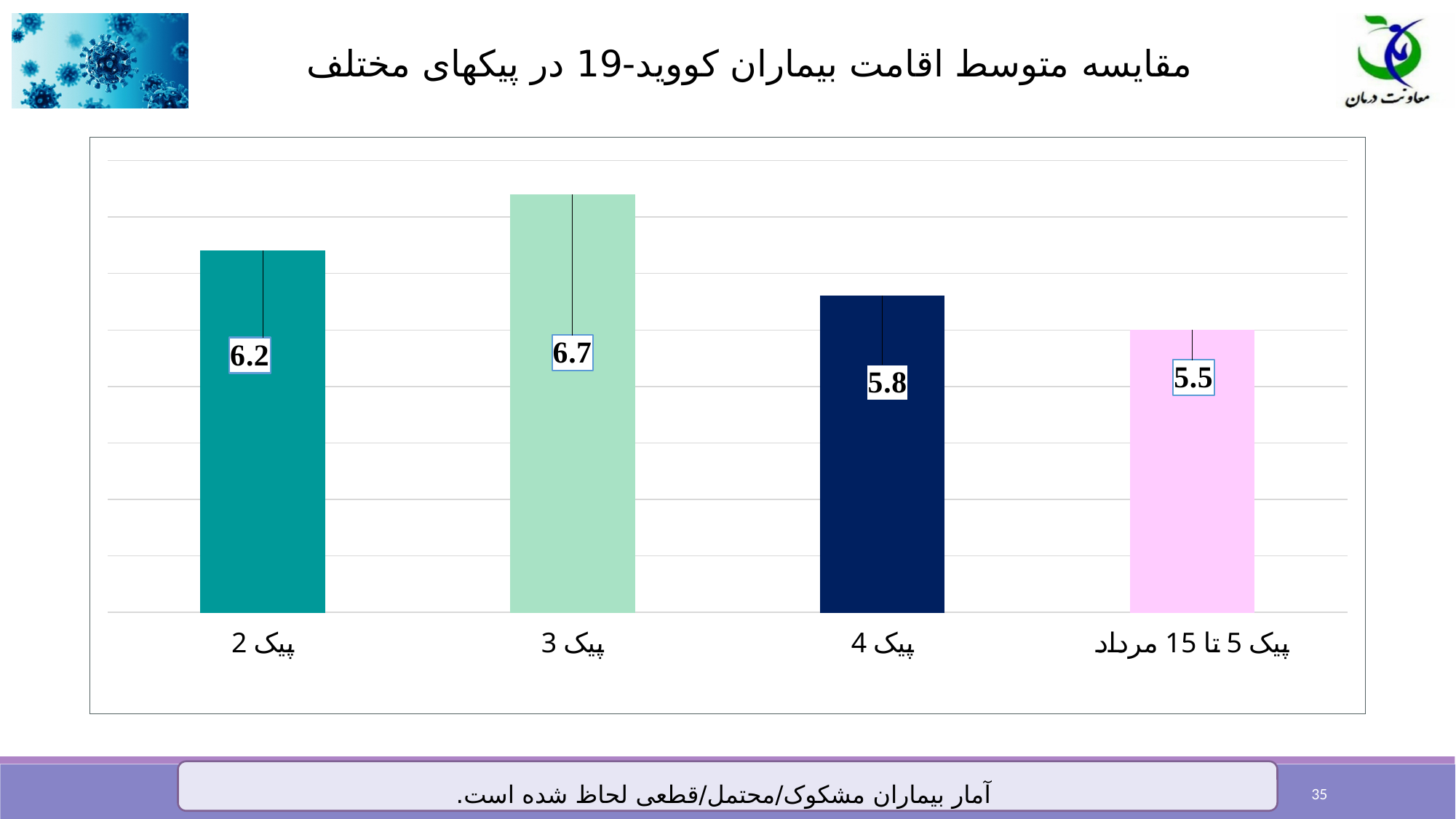
What is the value for پیک 3? 6.7 Which is larger, the value for پیک 2 or the value for پیک 4? پیک 2 What kind of chart is shown on the slide? bar chart What is the value for پیک 5 تا 15 مرداد? 5.5 What is the value for پیک 2? 6.2 What is the value for پیک 4? 5.8 What is the title of the chart on the slide? مقایسه متوسط اقامت بیماران کووید-19 در پیکهای مختلف How many categories are shown in the chart? 4 Which category has the lowest value? پیک 5 تا 15 مرداد What is the difference between the values for پیک 4 and پیک 5 تا 15 مرداد? 0.3 What is the difference between the values for پیک 3 and پیک 2? 0.5 Which category has the highest value? پیک 3